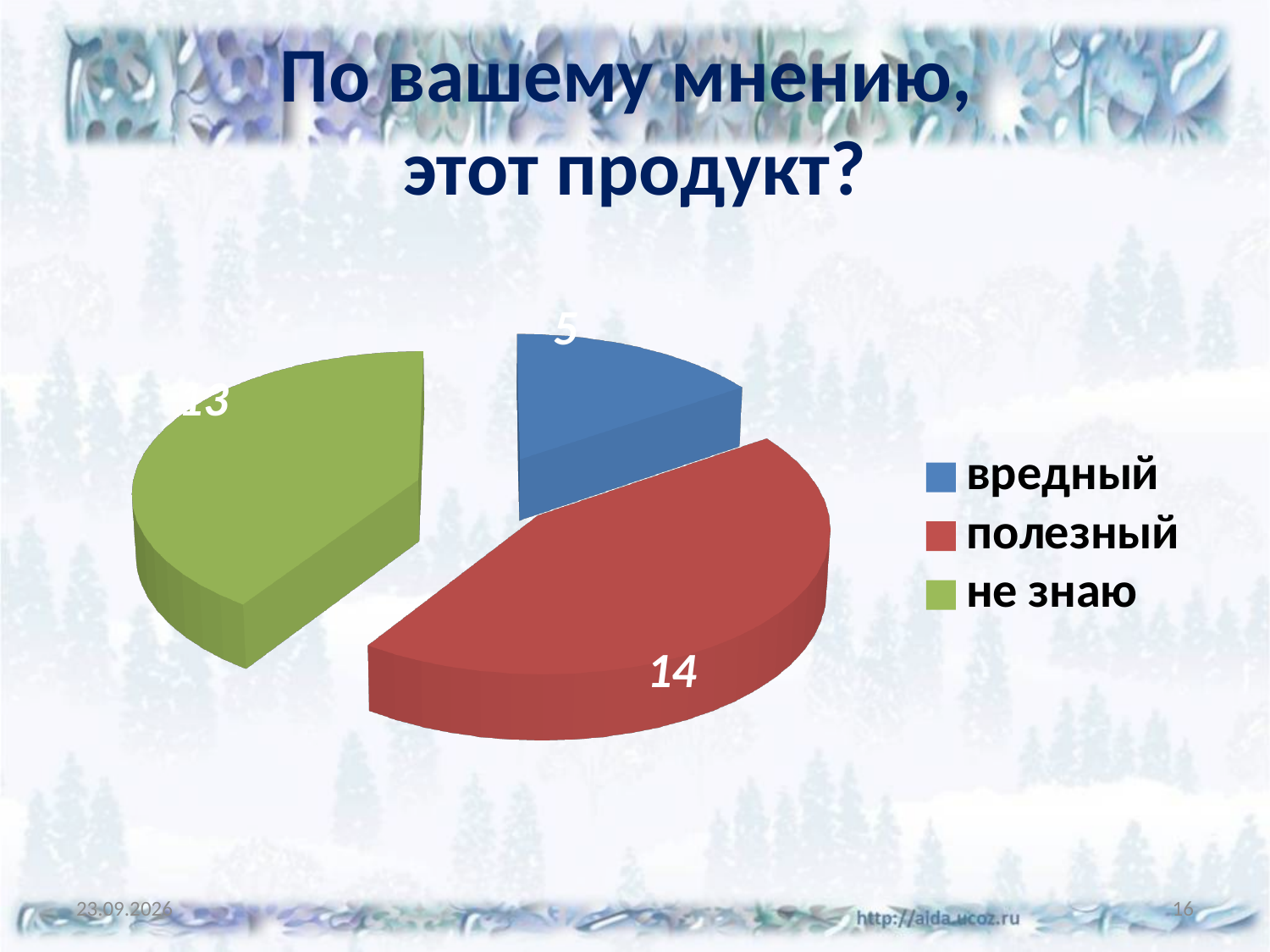
How many slices does the pie chart have? 3 Which is larger, the value for 'вредный' or the value for 'полезный'? полезный What is the value for the 'полезный' slice? 14 What is the value for the 'вредный' slice? 5 What kind of chart is shown on the slide? pie chart What is the difference between the values for 'полезный' and 'вредный'? 9 What colour is the 'не знаю' slice? green Which category has the smallest slice of the pie? вредный How many entries does the legend list? 3 What is the title of the slide containing the chart? По вашему мнению, этот продукт? Which category has the largest slice of the pie? полезный What is the value for the 'не знаю' slice? 13